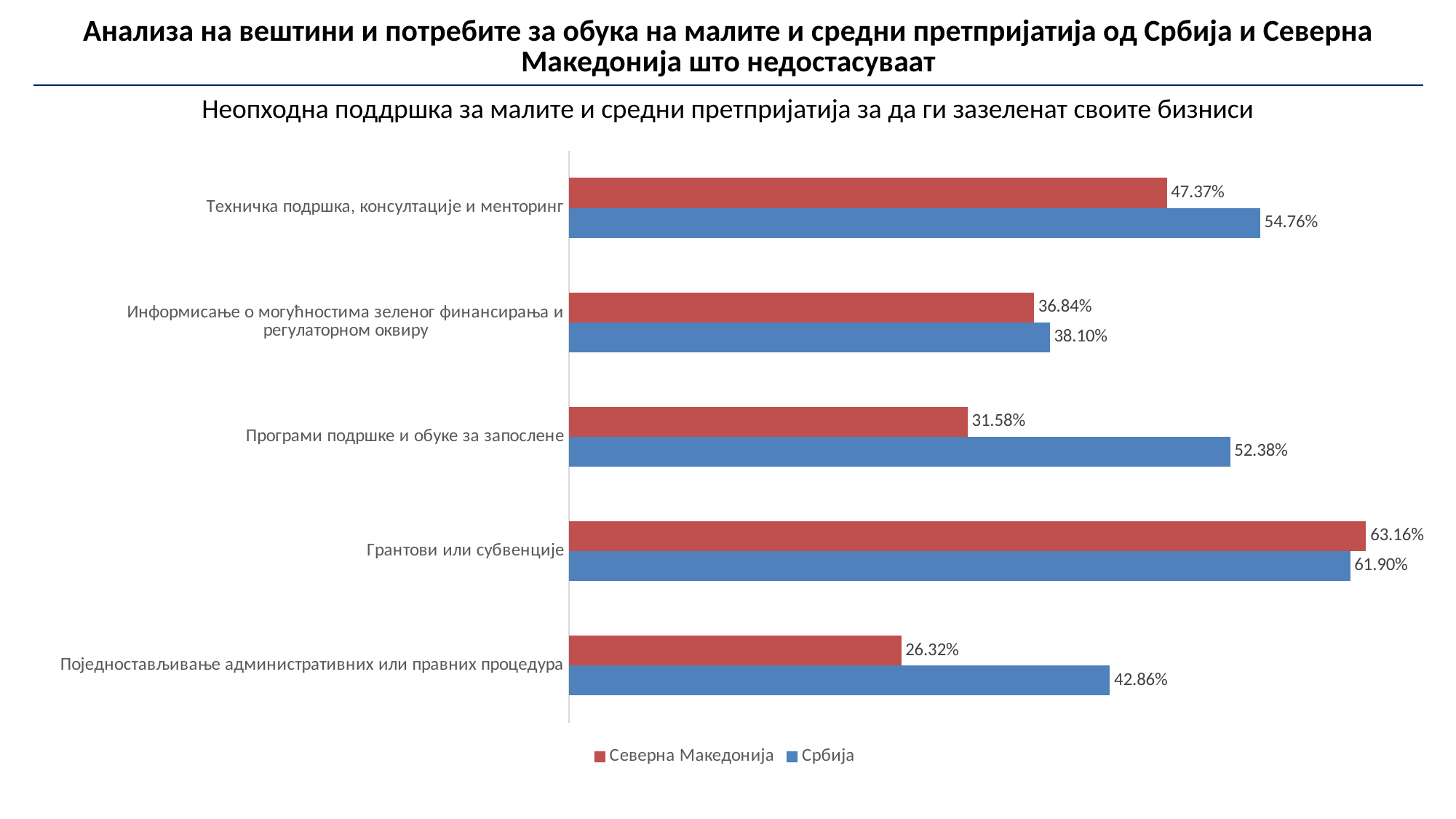
How many series does the legend list? 2 What is the value for Северна Македонија for Поједностављивање административних или правних процедура? 26.32% How many categories are shown on the chart? 5 What is the difference between the Србија and Северна Македонија values for Поједностављивање административних или правних процедура? 16.54% What is the value for Северна Македонија for Програми подршке и обуке за запослене? 31.58% What is the value for Србија for Информисање о могућностима зеленог финансирања и регулаторном оквиру? 38.10% Which category has the highest value for Северна Македонија? Грантови или субвенције For Грантови или субвенције, which series has the larger value, Северна Македонија or Србија? Северна Македонија What is the value for Србија for Техничка подршка, консултације и менторинг? 54.76% What is the difference between the Србија and Северна Македонија values for Програми подршке и обуке за запослене? 20.80% Which category has the lowest value for Србија? Информисање о могућностима зеленог финансирања и регулаторном оквиру What kind of chart is shown on the slide? Bar chart